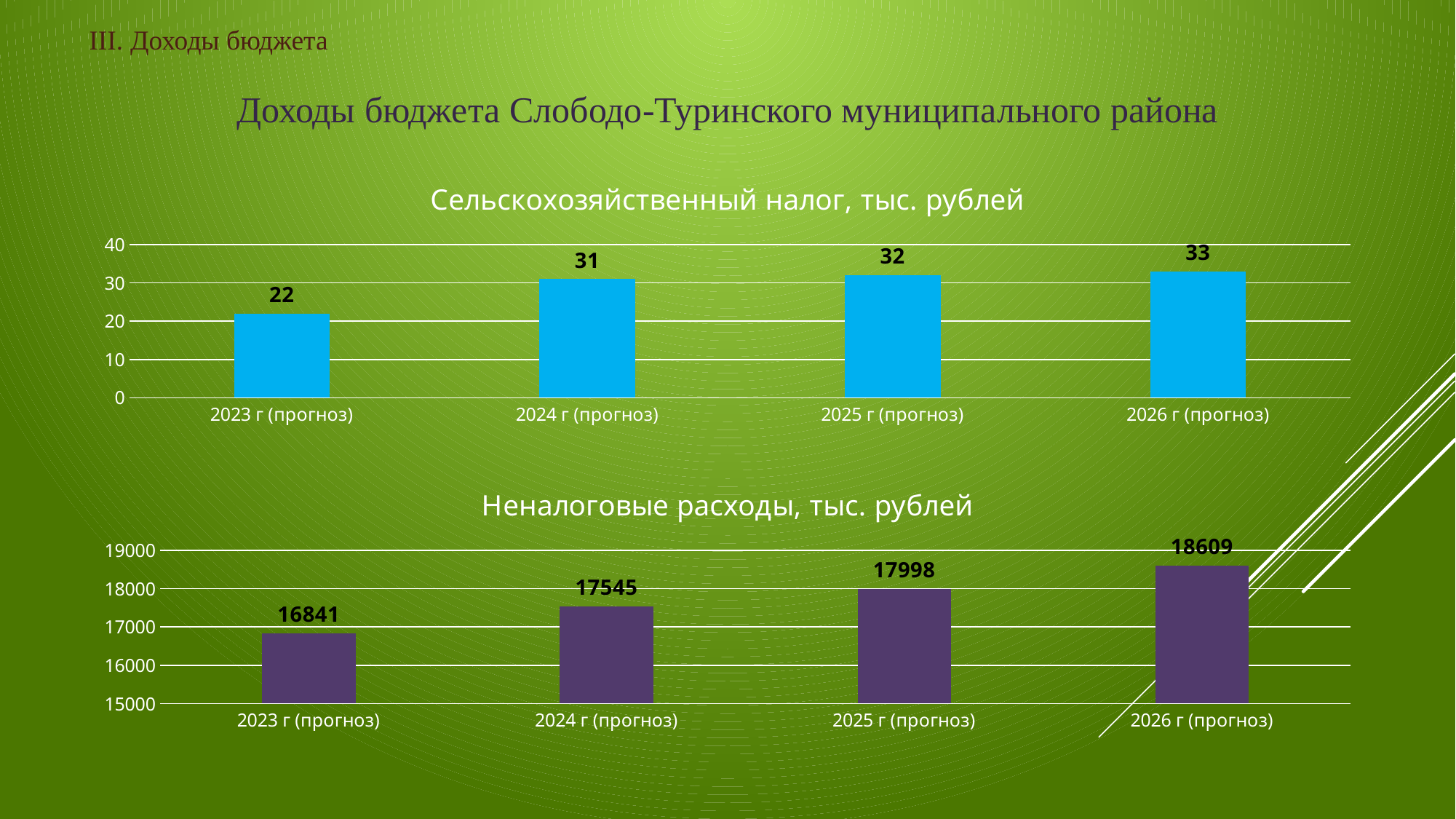
In the chart titled "Сельскохозяйственный налог, тыс. рублей", what is the value for 2023 г (прогноз)? 22 In the chart titled "Сельскохозяйственный налог, тыс. рублей", which year has the highest value? 2026 г (прогноз) In the chart titled "Неналоговые расходы, тыс. рублей", which is larger: the value for 2024 г (прогноз) or 2023 г (прогноз)? 2024 г (прогноз) What type of chart is the lower chart titled "Неналоговые расходы, тыс. рублей"? bar chart In the chart titled "Сельскохозяйственный налог, тыс. рублей", which year has the lowest value? 2023 г (прогноз) In the chart titled "Сельскохозяйственный налог, тыс. рублей", how many bars are plotted? 4 In the chart titled "Неналоговые расходы, тыс. рублей", what is the value for 2026 г (прогноз)? 18609 In the chart titled "Сельскохозяйственный налог, тыс. рублей", do the values rise or fall from 2023 to 2026? rise In the chart titled "Неналоговые расходы, тыс. рублей", which year has the lowest value? 2023 г (прогноз) In the chart titled "Сельскохозяйственный налог, тыс. рублей", what is the difference between the values for 2024 г (прогноз) and 2023 г (прогноз)? 9 In the chart titled "Неналоговые расходы, тыс. рублей", what is the value for 2025 г (прогноз)? 17998 In the chart titled "Неналоговые расходы, тыс. рублей", what is the difference between the values for 2026 г (прогноз) and 2025 г (прогноз)? 611